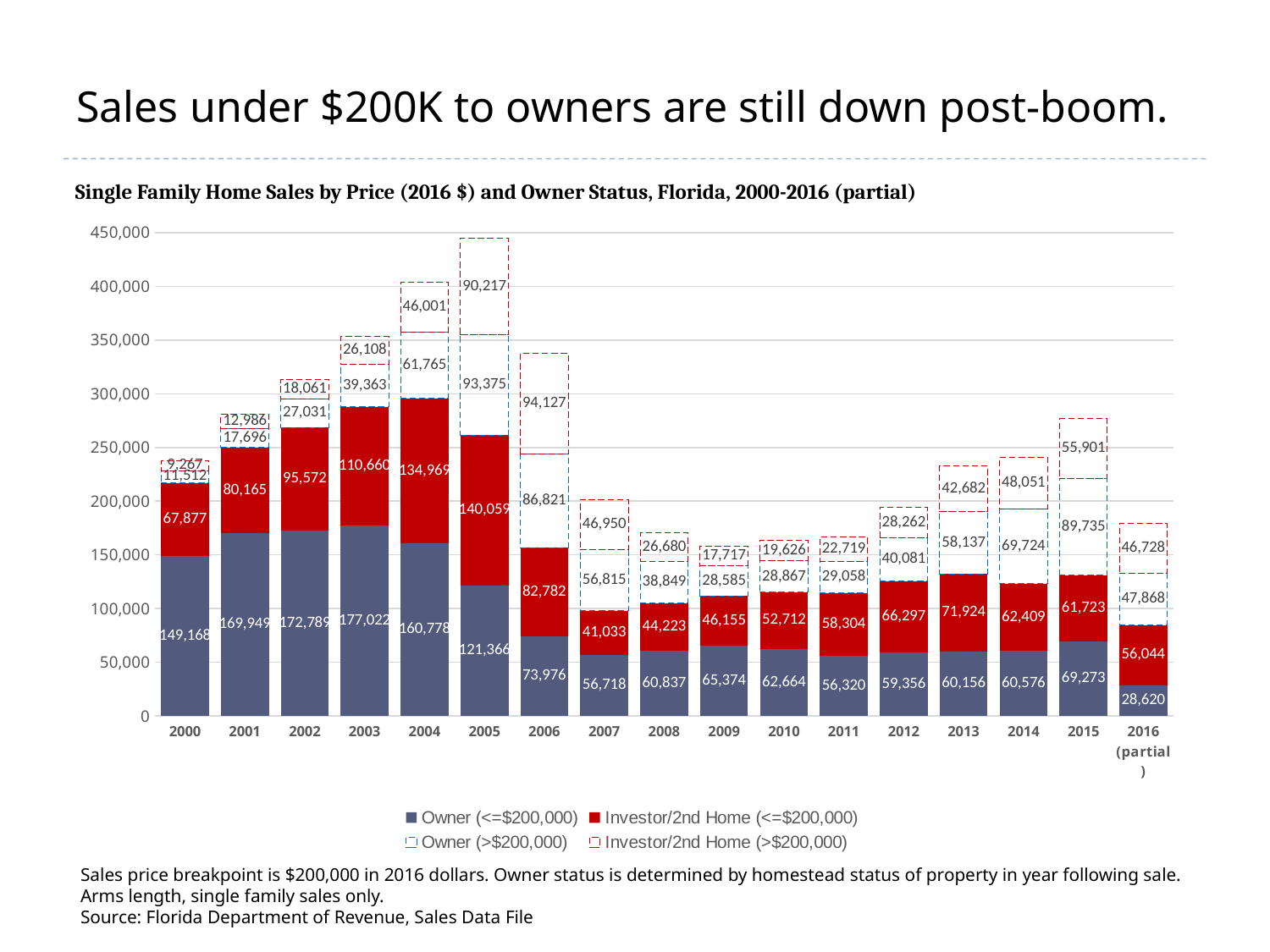
Is the total height of the 2005 stacked bar greater or less than 400,000? greater What is the value of Owner (<=$200,000) sales in 2003? 177,022 Which year has the highest Owner (<=$200,000) sales? 2003 What is the difference between Owner (<=$200,000) sales in 2003 and in 2016 (partial)? 148,402 What type of chart is shown on the slide? Stacked bar chart What is the value of Investor/2nd Home (>$200,000) sales in 2006? 94,127 What is the value of Owner (>$200,000) sales in 2015? 89,735 How many series does the legend list? 4 What is the total of the stacked bar for 2000? 237,824 What is the value of Investor/2nd Home (<=$200,000) sales in 2005? 140,059 Which year has the lowest Owner (<=$200,000) sales? 2016 (partial) Which is larger: Investor/2nd Home (<=$200,000) sales in 2004 or in 2006? 2004